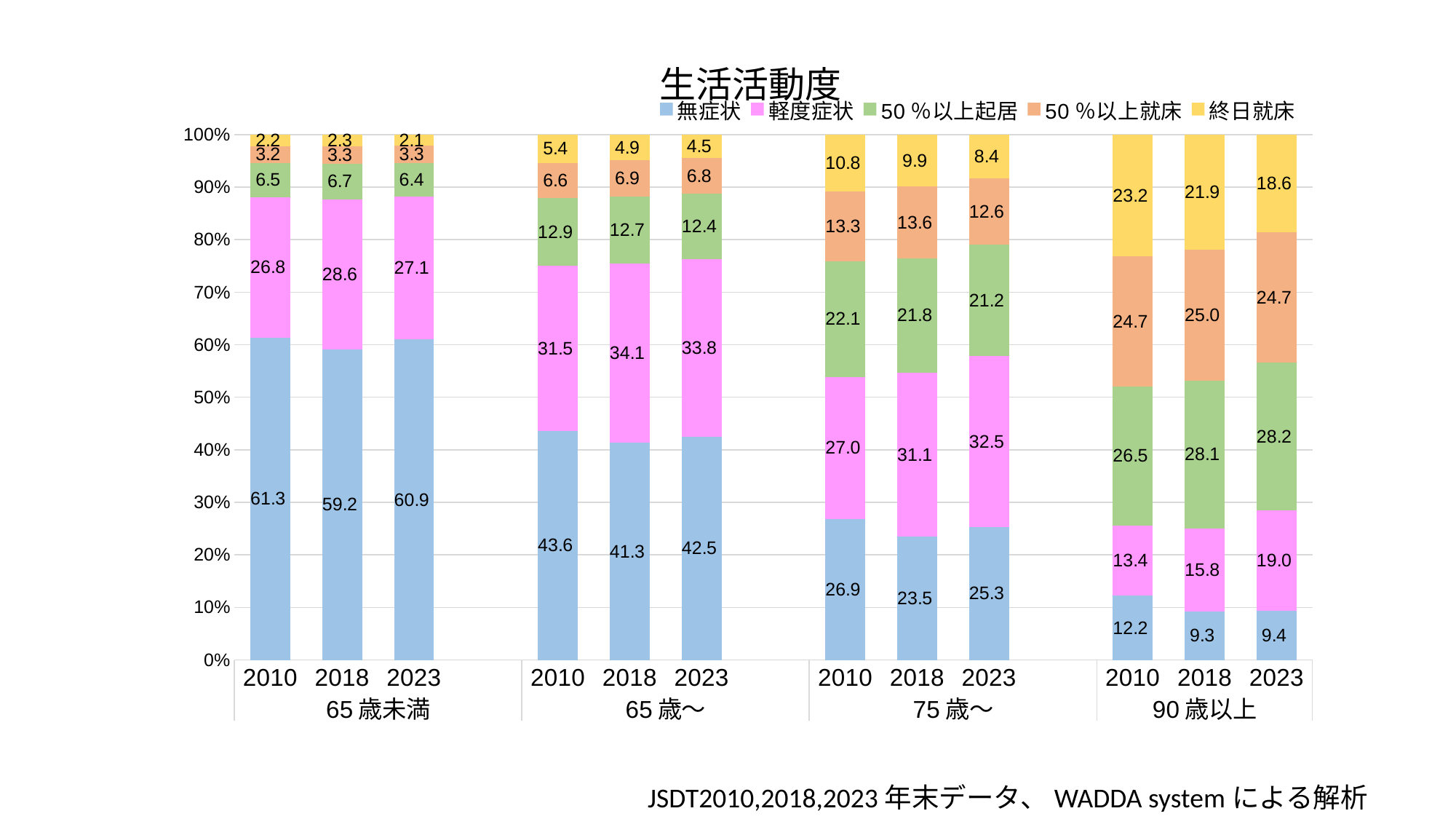
What is the value of 無症状 for the 2010 bar in the 65歳未満 group? 61.3 In the 75歳〜 group, does the 終日就床 value rise or fall from 2010 to 2023? Fall What is the value of 軽度症状 for the 2018 bar in the 75歳〜 group? 31.1 What is the value of 終日就床 for the 2023 bar in the 90歳以上 group? 18.6 In the 65歳未満 group, what is the difference between the 無症状 values for 2010 and 2018? 2.1 Across all bars on the chart, which bar has the lowest 無症状 value? 90歳以上 2018 How many stacked bars are plotted on the chart? 12 In the 65歳〜 group, is the 軽度症状 value larger in 2018 or in 2023? 2018 What colour represents 無症状 in the legend? Blue Within the 90歳以上 group, which year has the highest 終日就床 value? 2010 What kind of chart is shown on the slide? Stacked bar chart How many series does the legend list? 5